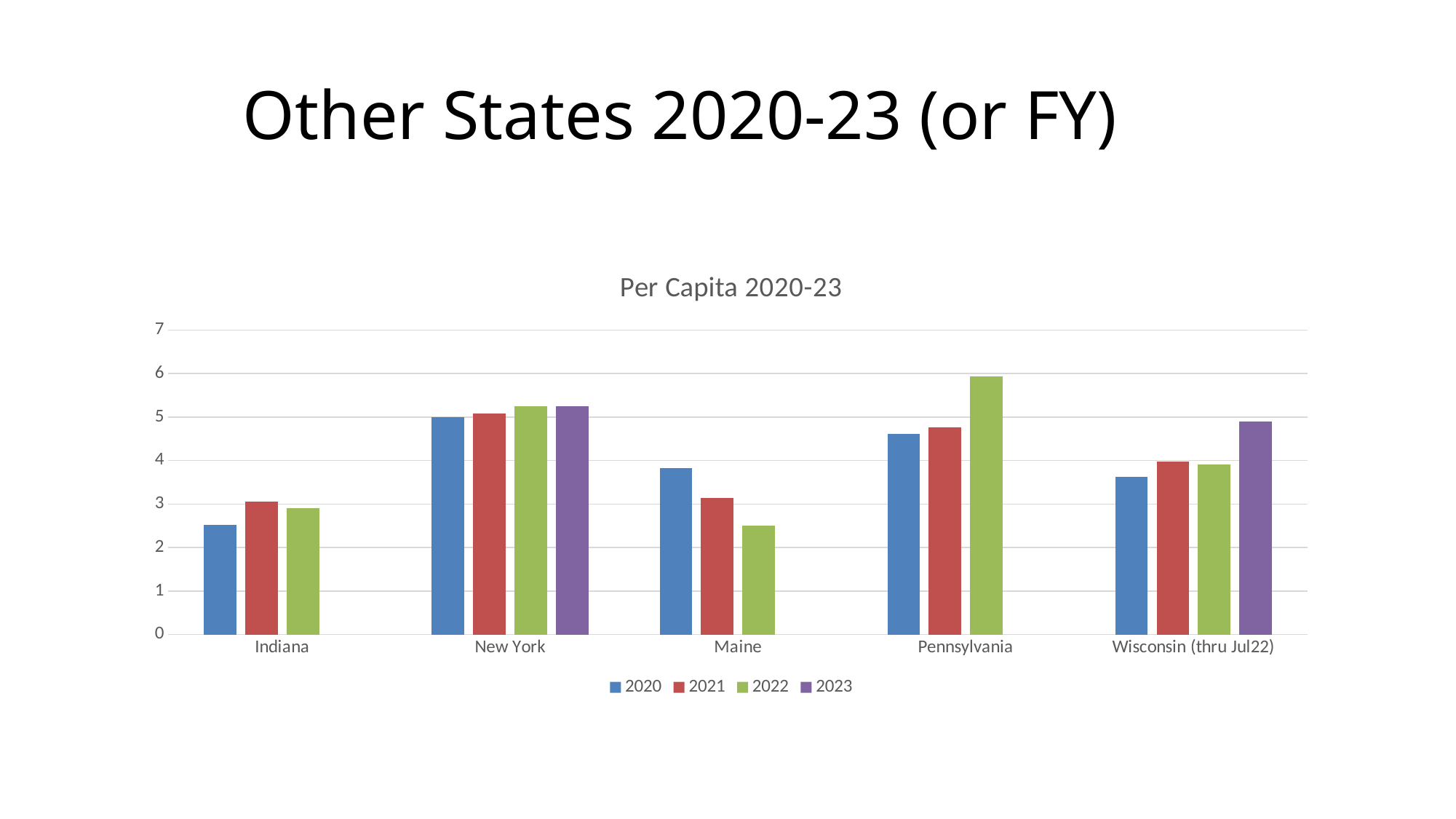
For Maine, which is larger: the 2020 value or the 2022 value? 2020 Which state has the lowest value for 2020? Indiana Which state has the highest value for 2022? Pennsylvania Is the 2023 value for Wisconsin (thru Jul22) greater or less than 4? greater What kind of chart is shown on the slide? bar chart What is the title of the chart? Per Capita 2020-23 Which states have a bar for 2023? New York and Wisconsin (thru Jul22) Is the 2020 value for Indiana greater or less than 3? less Is the 2022 value for Pennsylvania greater or less than 5? greater Do the values for Maine rise or fall from 2020 to 2022? fall How many states (categories) are shown on the x axis? 5 How many series does the legend list? 4